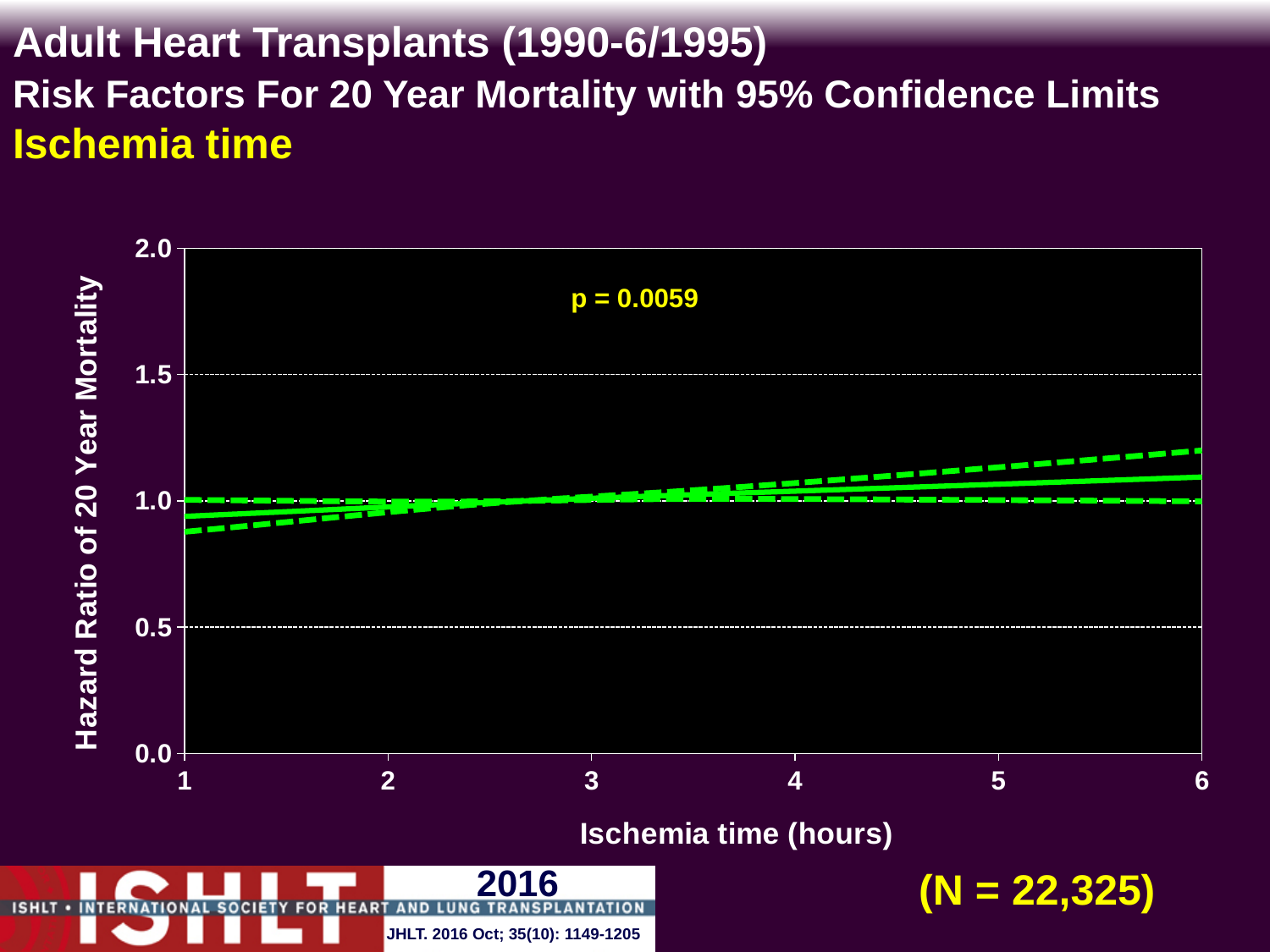
What is the label of the x axis? Ischemia time (hours) Is the hazard ratio (solid line) at an ischemia time of 6 hours greater or less than 1.5? less What is the sample size (N) shown on the slide? N = 22,325 Is the upper 95% confidence limit at an ischemia time of 6 hours greater or less than 1.0? greater Is the lower 95% confidence limit at an ischemia time of 1 hour greater or less than 1.0? less What is the label of the y axis? Hazard Ratio of 20 Year Mortality How many lines are plotted on the chart (including the confidence limits)? 3 What kind of chart is shown on the slide? line chart Does the hazard ratio (solid line) rise or fall as ischemia time increases from 1 to 6 hours? rise What p-value is printed on the chart? p = 0.0059